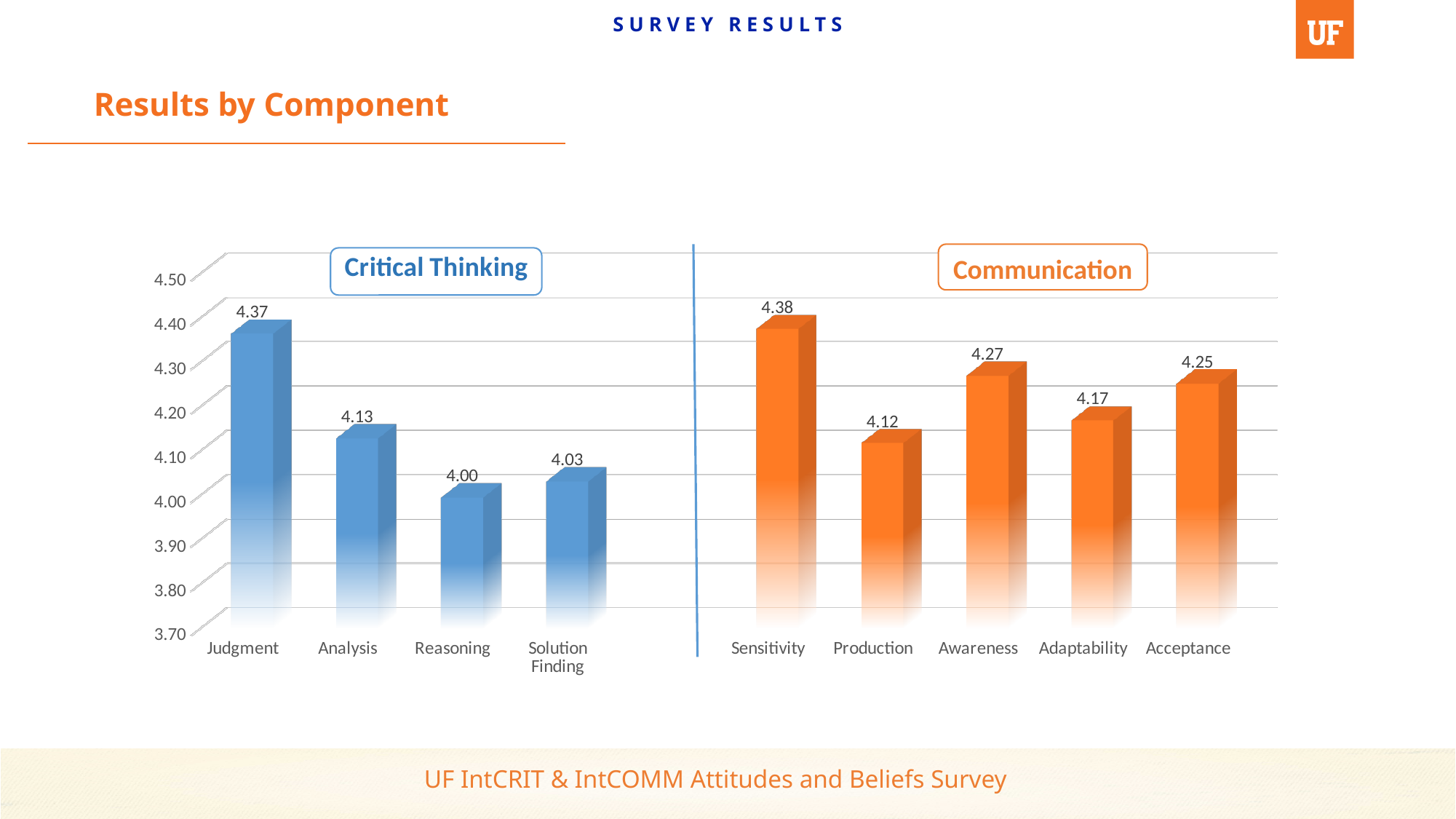
Is the value for Adaptability greater or less than 4.10? greater What kind of chart is shown on the slide? bar chart How many components are plotted in the chart? 9 What colour are the bars for the Communication components? orange What is the value for Solution Finding? 4.03 What is the value for Awareness? 4.27 What is the difference between the values for Sensitivity and Production? 0.26 Which Communication component has the highest value? Sensitivity What is the value for Judgment? 4.37 Which is larger, the value for Awareness or the value for Acceptance? Awareness Which Critical Thinking component has the lowest value? Reasoning What is the difference between the values for Judgment and Reasoning? 0.37